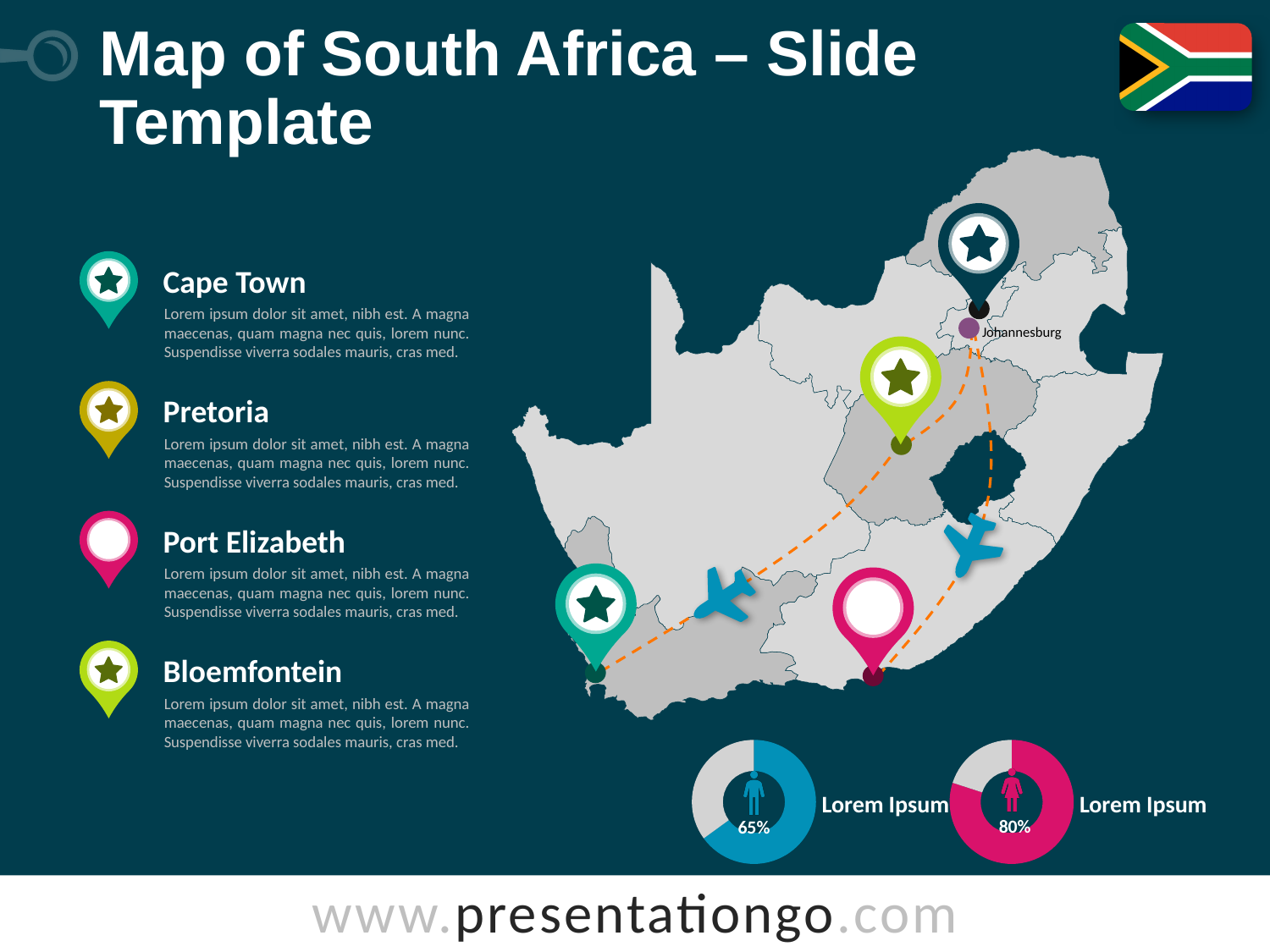
How many donut charts are shown at the bottom of the slide? 2 Which donut chart shows the larger value, the blue one on the left or the pink one on the right? The pink one on the right What percentage is shown in the pink donut chart on the right at the bottom of the slide? 80% What colour is the filled portion of the donut chart showing 65%? Blue Is the value in the blue donut chart greater or less than 50%? greater What share of the pink donut chart on the right is left unfilled (grey)? 20% What kind of chart is used to display the 65% and 80% values at the bottom of the slide? Donut (pie) chart What share of the blue donut chart on the left is left unfilled (grey)? 35% Is the value in the pink donut chart greater or less than 75%? greater What text label appears next to each of the two donut charts? Lorem Ipsum What percentage is shown in the blue donut chart on the left at the bottom of the slide? 65% What is the difference between the value in the pink donut chart and the value in the blue donut chart? 15 percentage points